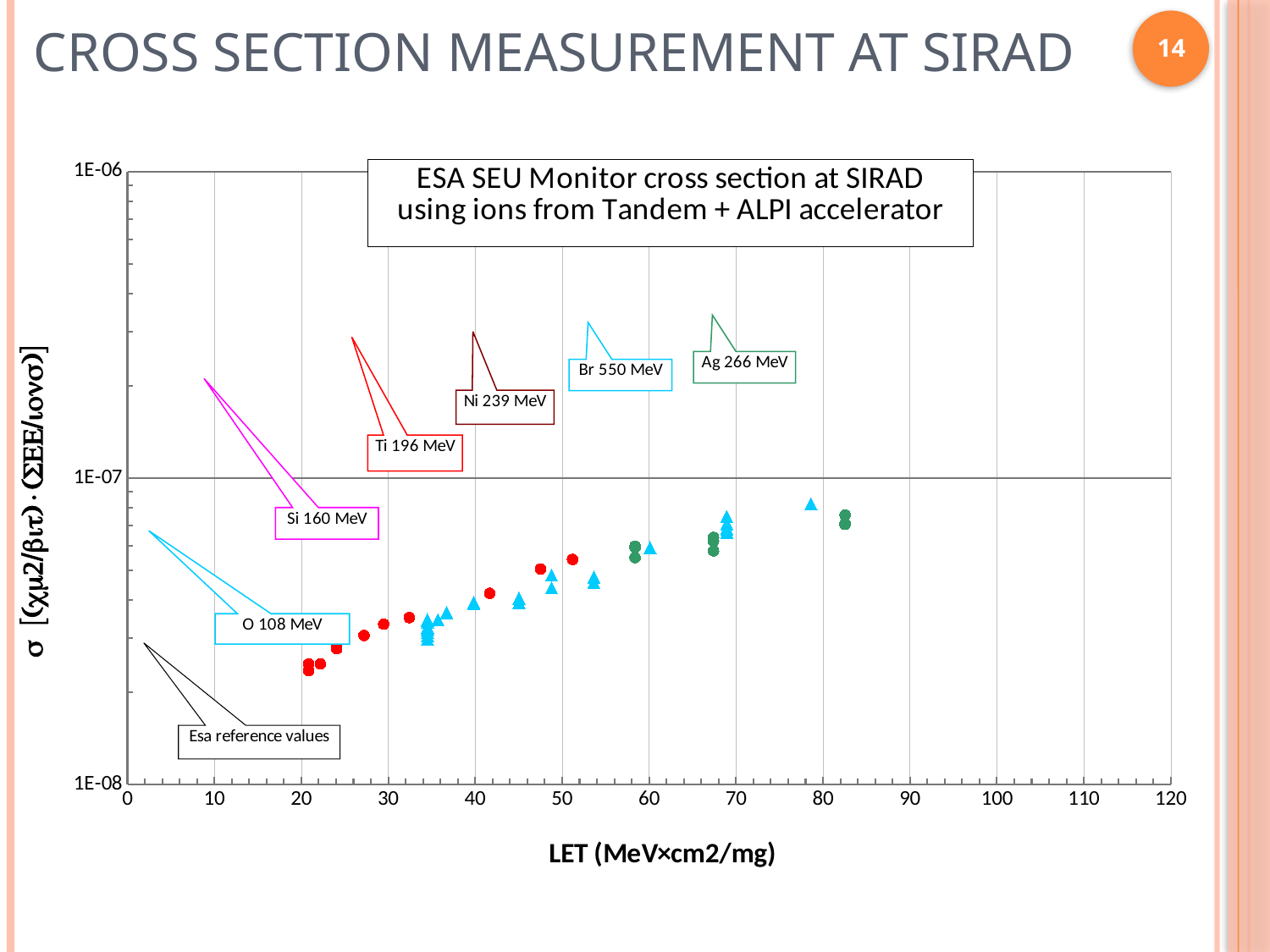
Are the plotted points near LET 20 greater or less than 1E-08? greater Which ion annotation is labelled with 550 MeV? Br 550 MeV What is the lowest value shown on the y axis? 1E-08 What is the title of the chart? ESA SEU Monitor cross section at SIRAD using ions from Tandem + ALPI accelerator What kind of chart is shown on the slide? Scatter chart Are the plotted points near LET 80 greater or less than 1E-07? less Are any of the plotted points above 1E-07 on the y axis? No Do the plotted cross section values rise or fall as LET increases along the x axis? Rise How many ion energy callout labels (e.g. 'Si 160 MeV') are shown on the chart? 6